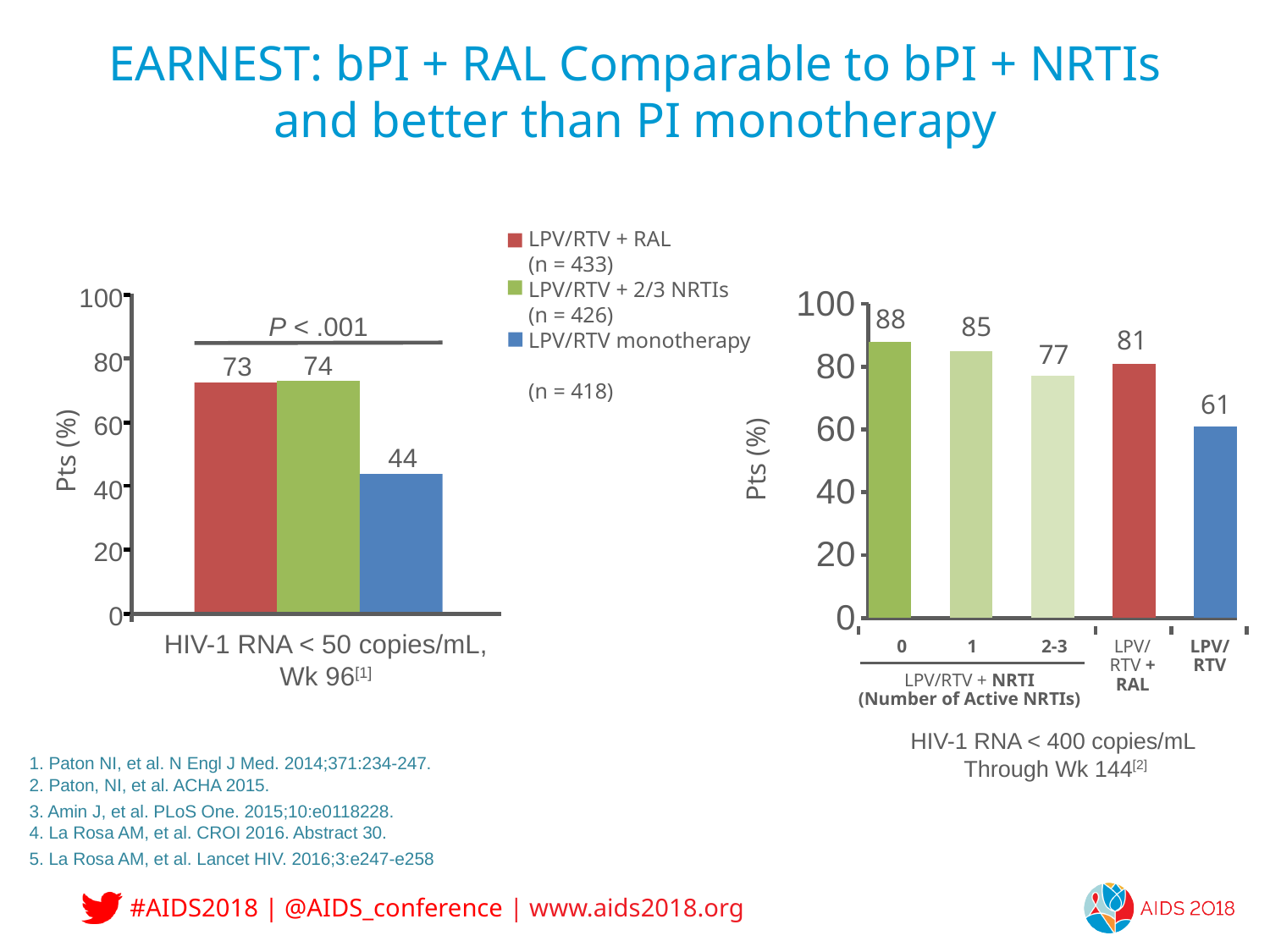
In the left chart (HIV-1 RNA < 50 copies/mL, Wk 96), what is the value for LPV/RTV monotherapy? 44 In the left chart (HIV-1 RNA < 50 copies/mL, Wk 96), what is the value for LPV/RTV + RAL? 73 In the right chart (HIV-1 RNA < 400 copies/mL Through Wk 144), which category has the highest value? 0 (LPV/RTV + NRTI) In the left chart (HIV-1 RNA < 50 copies/mL, Wk 96), which series has the lowest value? LPV/RTV monotherapy In the right chart (HIV-1 RNA < 400 copies/mL Through Wk 144), how many bars are plotted? 5 In the right chart (HIV-1 RNA < 400 copies/mL Through Wk 144), what is the difference between the value for 2-3 active NRTIs and the value for LPV/RTV? 16 In the right chart (HIV-1 RNA < 400 copies/mL Through Wk 144), what is the value for LPV/RTV + NRTI with 0 active NRTIs? 88 How many series does the legend list for the left chart (HIV-1 RNA < 50 copies/mL, Wk 96)? 3 In the right chart (HIV-1 RNA < 400 copies/mL Through Wk 144), which category has the lowest value? LPV/RTV In the right chart (HIV-1 RNA < 400 copies/mL Through Wk 144), what is the value for LPV/RTV + RAL? 81 What kind of chart is the left chart (HIV-1 RNA < 50 copies/mL, Wk 96)? Bar chart In the left chart (HIV-1 RNA < 50 copies/mL, Wk 96), what is the difference between the LPV/RTV + 2/3 NRTIs value and the LPV/RTV monotherapy value? 30